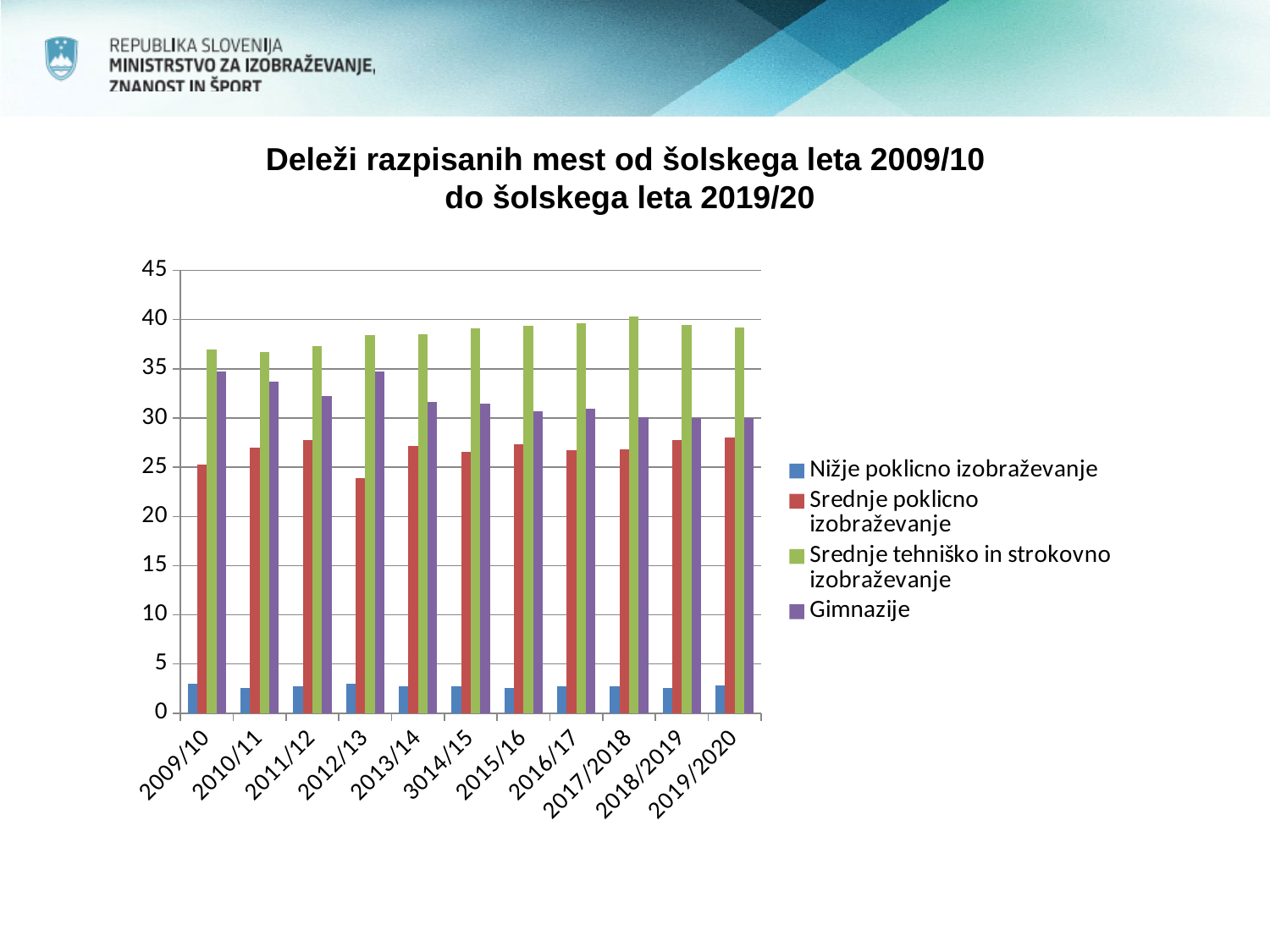
Is the value for Gimnazije in 2009/10 greater or less than 30? greater How many school years are shown on the x axis? 11 What kind of chart is shown on the slide? bar chart Do the values for Gimnazije rise or fall from 2009/10 to 2019/2020? fall In which school year is the value for Srednje poklicno izobraževanje lowest? 2012/13 Is the value for Srednje tehniško in strokovno izobraževanje in 2017/2018 greater or less than 35? greater In 2009/10, which is larger: Gimnazije or Srednje poklicno izobraževanje? Gimnazije How many series does the legend list? 4 Is the value for Nižje poklicno izobraževanje in 2009/10 greater or less than 5? less Which series has the highest value in 2019/2020? Srednje tehniško in strokovno izobraževanje Which series has the lowest value in every school year shown? Nižje poklicno izobraževanje